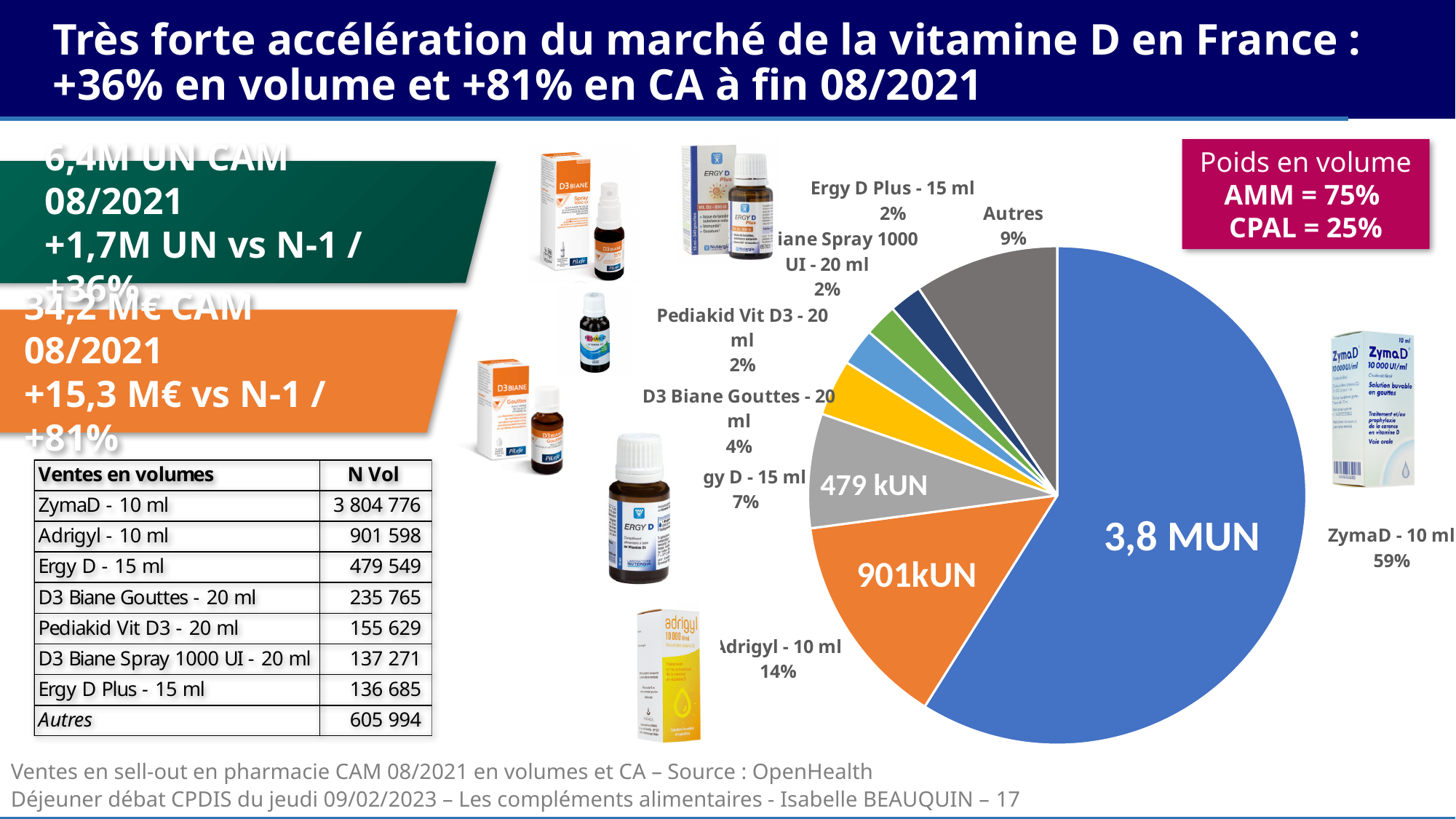
What kind of chart is shown on the slide? pie chart What share of the pie chart does the Autres slice represent? 9% Which is larger in the pie chart, the share of Adrigyl - 10 ml or the share of Autres? Adrigyl - 10 ml What volume value is printed on the ZymaD - 10 ml slice of the pie chart? 3,8 MUN What volume value is printed on the Ergy D - 15 ml slice of the pie chart? 479 kUN What share of the pie chart does Ergy D - 15 ml represent? 7% What share of the pie chart does D3 Biane Gouttes - 20 ml represent? 4% Which slice of the pie chart is the largest? ZymaD - 10 ml What volume value is printed on the Adrigyl - 10 ml slice of the pie chart? 901kUN How many slices does the pie chart have? 8